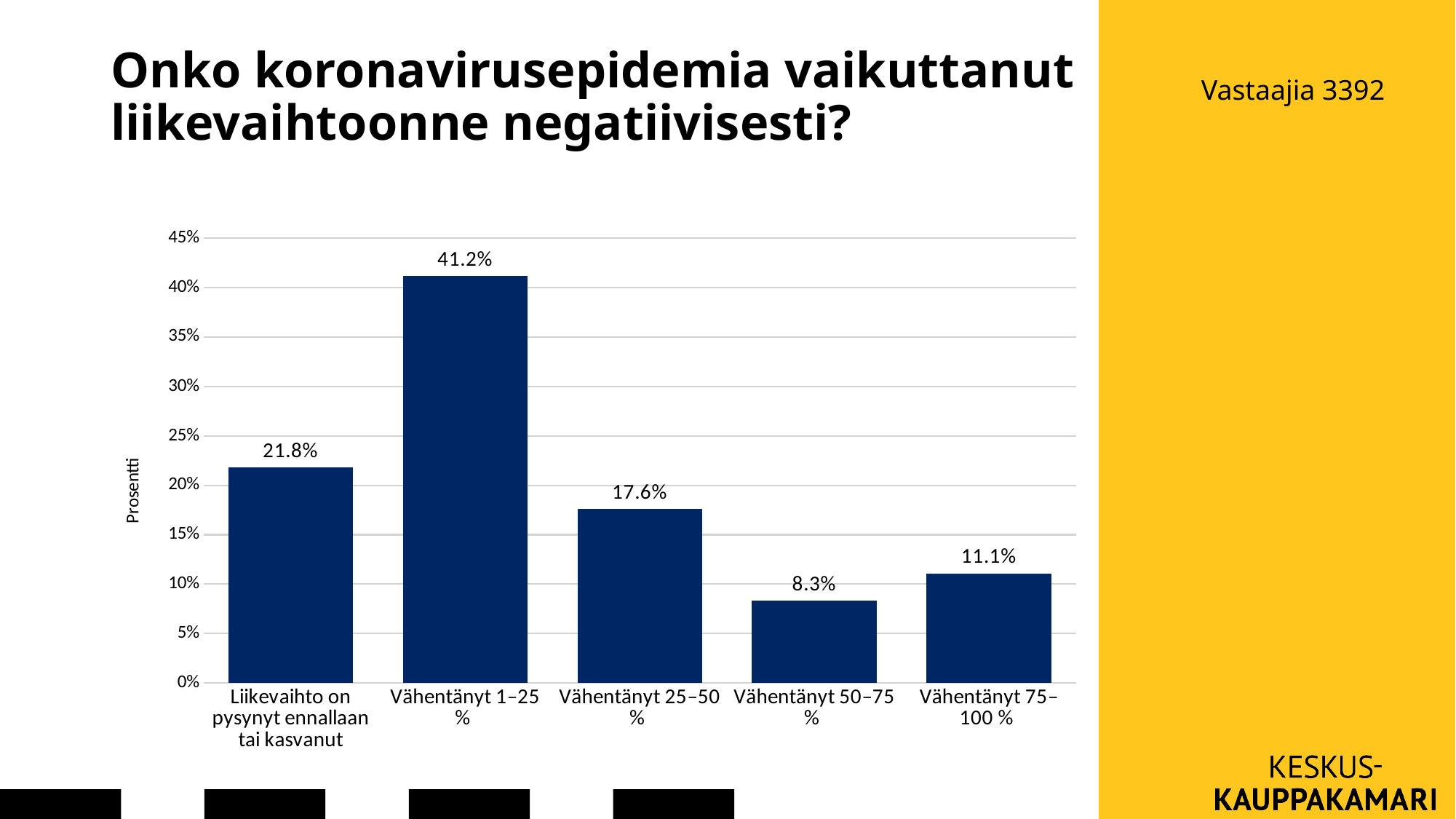
What is the value for "Liikevaihto on pysynyt ennallaan tai kasvanut"? 21.8% What is the value for "Vähentänyt 75–100 %"? 11.1% Which is larger, the value for "Liikevaihto on pysynyt ennallaan tai kasvanut" or the value for "Vähentänyt 25–50 %"? Liikevaihto on pysynyt ennallaan tai kasvanut What is the value for "Vähentänyt 1–25 %"? 41.2% What is the label of the vertical axis? Prosentti What is the value for "Vähentänyt 50–75 %"? 8.3% How many categories are shown on the x axis? 5 Which category has the lowest value? Vähentänyt 50–75 % Which category has the highest value? Vähentänyt 1–25 % What is the difference between the values for "Vähentänyt 1–25 %" and "Vähentänyt 25–50 %"? 23.6% What kind of chart is shown on the slide? bar chart Is the value for "Vähentänyt 75–100 %" greater or less than 10%? greater